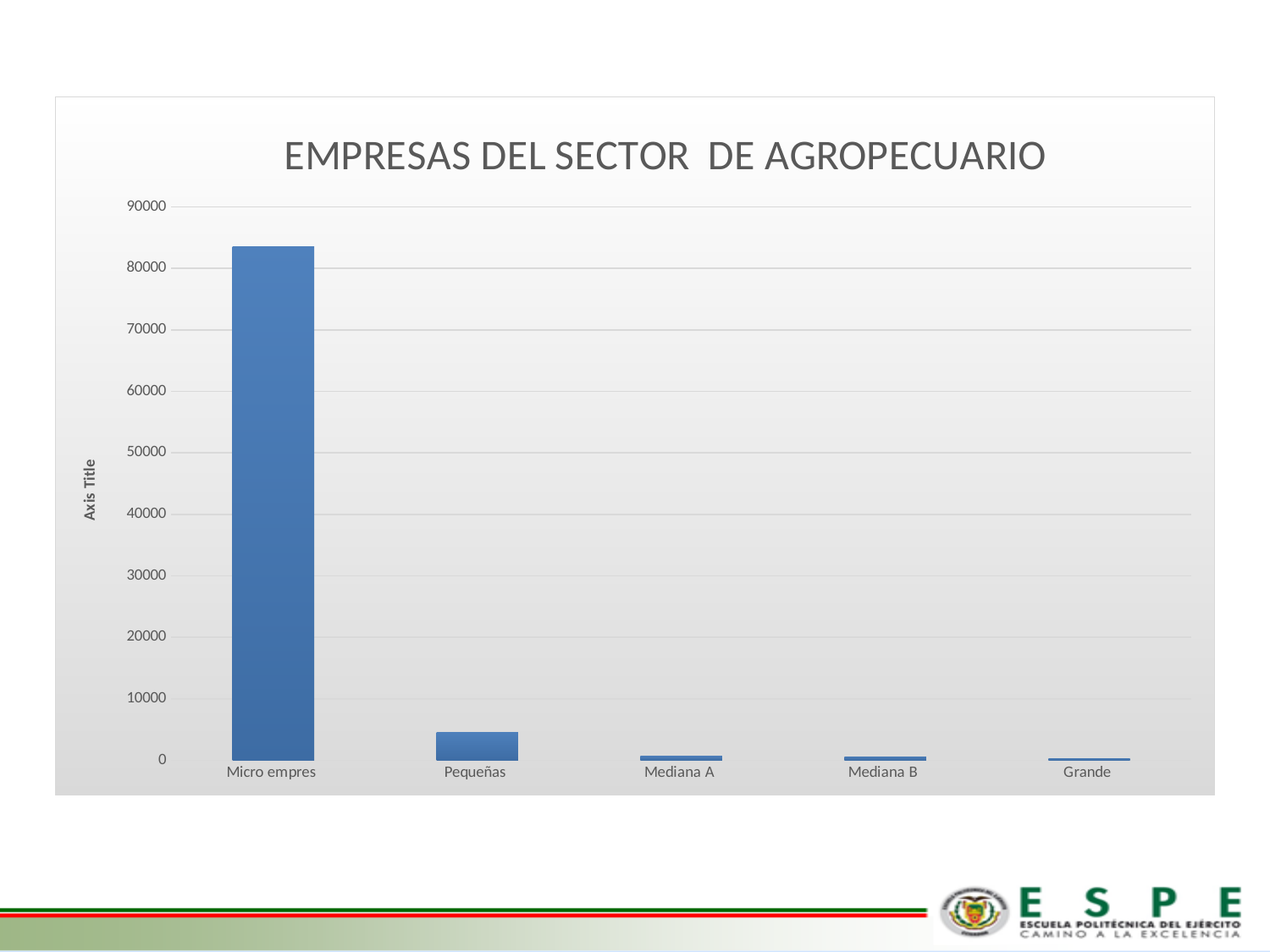
Which is larger, the value for Micro empres or the value for Pequeñas? Micro empres Which is larger, the value for Pequeñas or the value for Grande? Pequeñas Is the value for Micro empres greater or less than 80000? greater What is the title of the chart? EMPRESAS DEL SECTOR DE AGROPECUARIO How many categories are shown on the x axis of the chart? 5 Is the value for Micro empres greater or less than 90000? less Is the value for Mediana A greater or less than 10000? less What label is shown on the vertical axis of the chart? Axis Title Do the values generally rise or fall from left to right along the x axis? fall What kind of chart is shown on the slide? bar chart Which category has the highest value in the chart? Micro empres